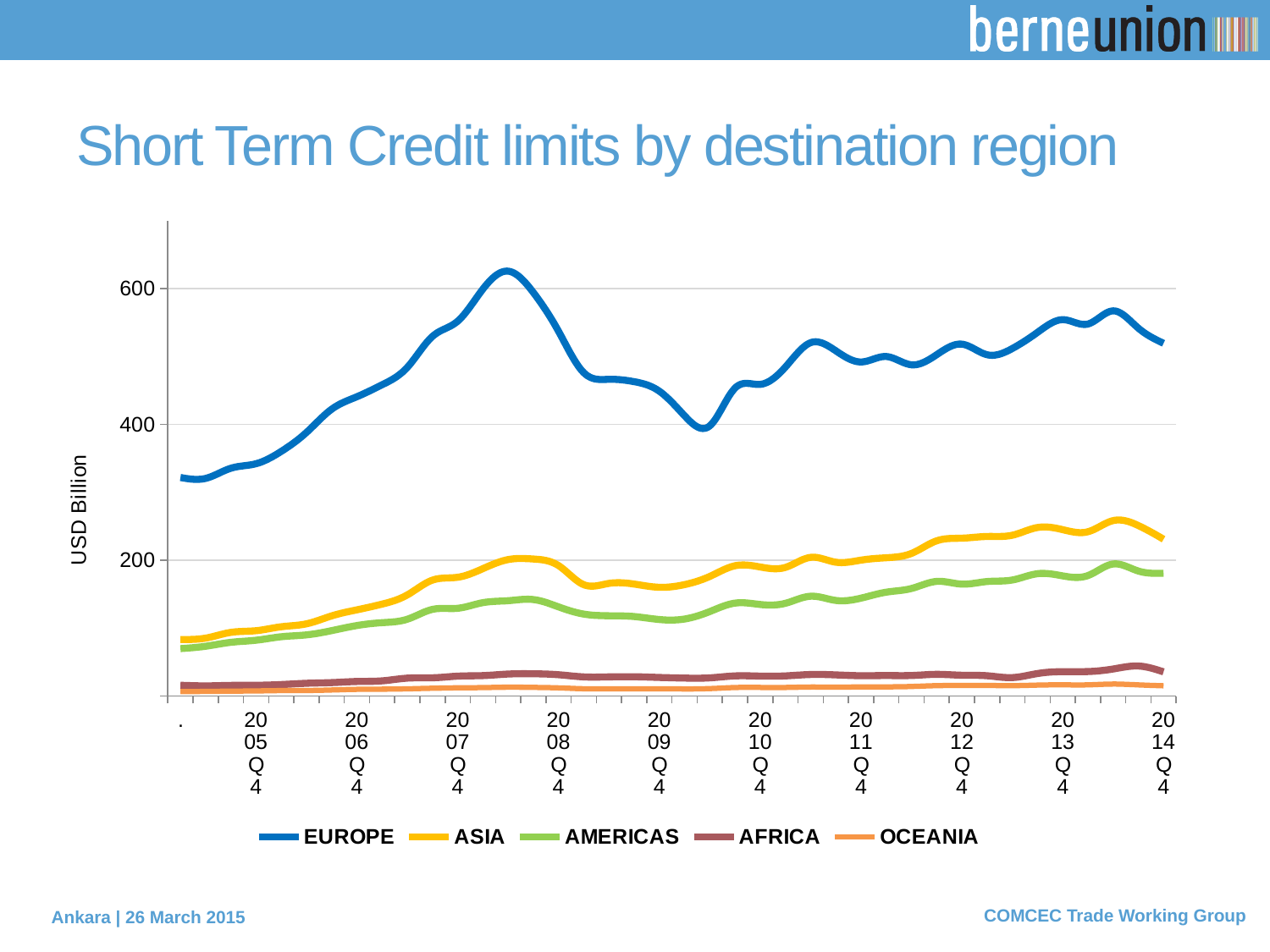
What kind of chart is shown on the slide? line chart Does the ASIA line generally rise or fall from 2005 Q4 to 2014 Q4? rise Is the value for AFRICA at 2014 Q4 greater or less than 200? less Is the value for ASIA at 2005 Q4 greater or less than 200? less How many series does the legend list? 5 Is the value for ASIA at 2014 Q4 greater or less than 200? greater Which region has the lowest short term credit limits throughout the period? OCEANIA Which is larger at 2014 Q4, the value for ASIA or the value for AMERICAS? ASIA What unit is shown on the vertical axis? USD Billion Which region has the highest short term credit limits throughout the period? EUROPE